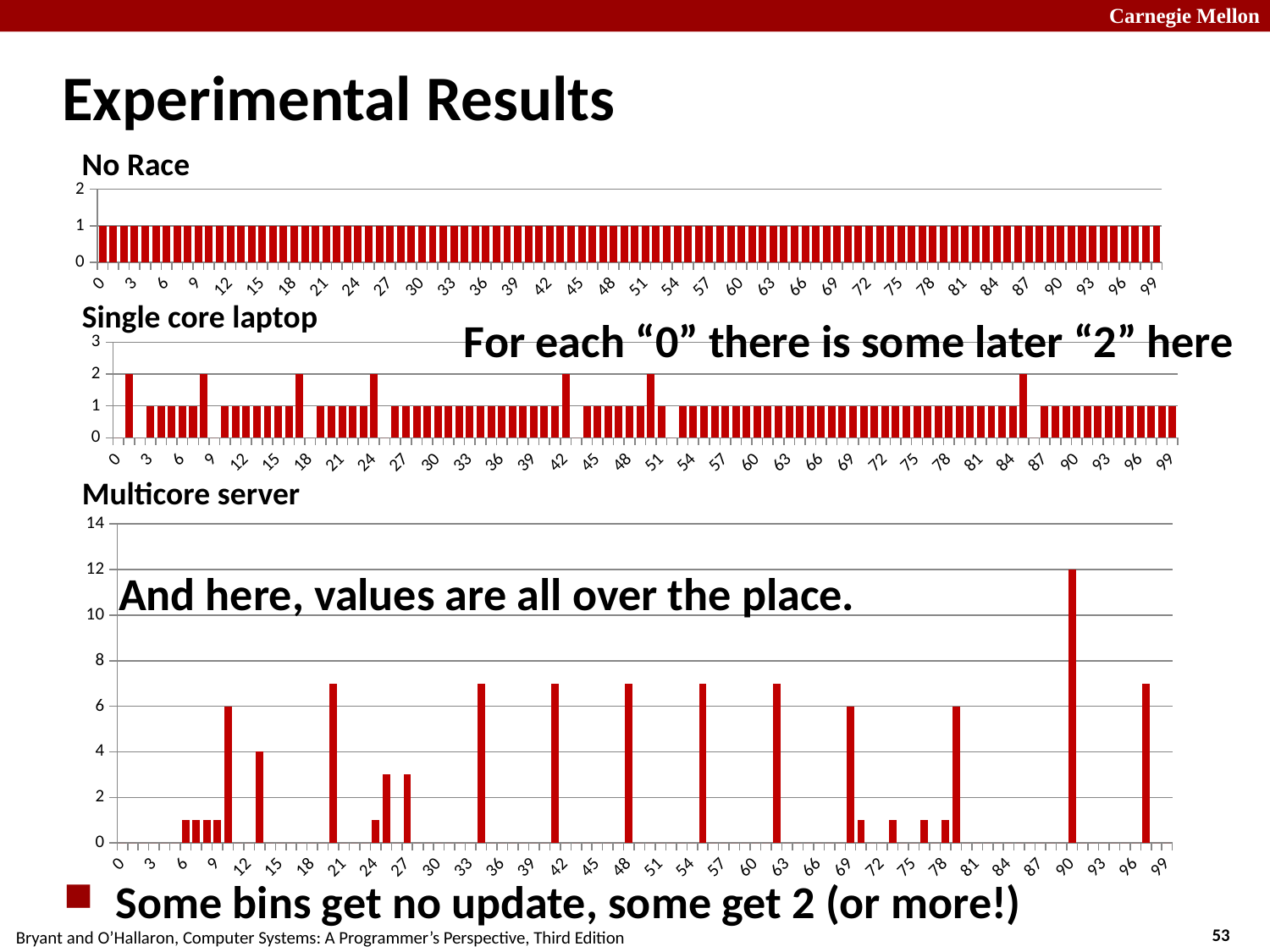
What is the title of the top chart on the slide? No Race How many charts are shown on the slide? 3 In the "Multicore server" chart, how many bars reach a value of 12? 1 In the "No Race" chart, what value do all the bars reach? 1 In the "Single core laptop" chart, what is the highest value reached by any bar? 2 What is the last label on the x axis of the "Multicore server" chart? 99 What is the highest value shown on the y axis of the "Multicore server" chart? 14 What kind of chart is the "No Race" chart? bar chart Which chart has the larger maximum bar value, "Single core laptop" or "Multicore server"? Multicore server In the "No Race" chart, what is the highest value reached by any bar? 1 In the "Multicore server" chart, what is the highest value reached by any bar? 12 In the "Multicore server" chart, is the tallest bar greater or less than 10? greater